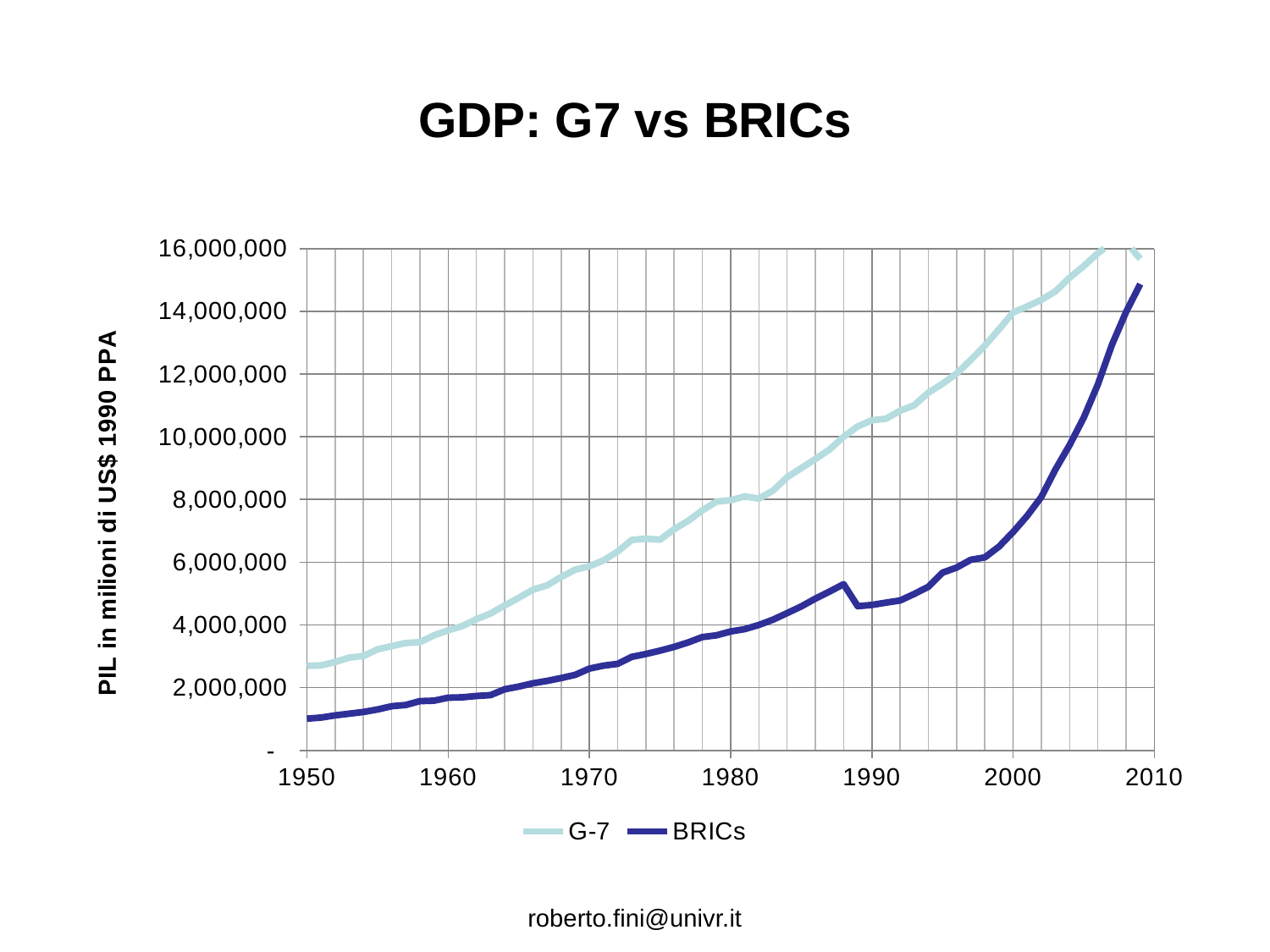
How many series does the legend list? 2 Is the value for G-7 in 1950 greater or less than 2,000,000? greater Which series has the larger value in 1990, G-7 or BRICs? G-7 Is the value for BRICs in 1950 greater or less than 2,000,000? less Do the BRICs values generally rise or fall from 1950 to 2010? rise What kind of chart is shown on the slide? line chart Is the value for G-7 in 1990 greater or less than 10,000,000? greater What is the label on the vertical axis? PIL in milioni di US$ 1990 PPA What is the title of the chart? GDP: G7 vs BRICs